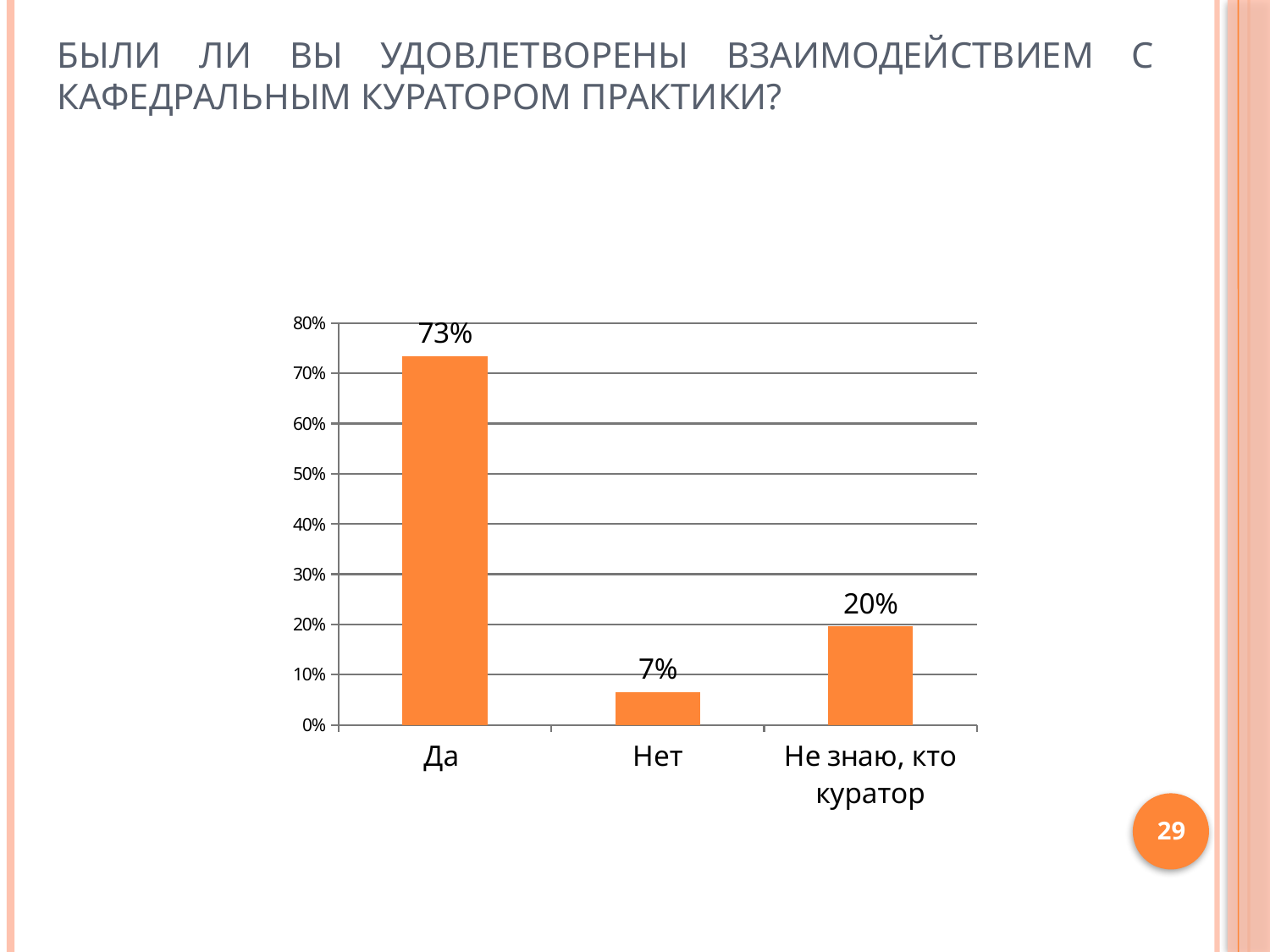
What kind of chart is shown on the slide? bar chart What is the difference between the values for "Не знаю, кто куратор" and "Нет"? 13% What is the value for "Нет"? 7% What is the value for "Да"? 73% Which is larger, the value for "Нет" or the value for "Не знаю, кто куратор"? Не знаю, кто куратор What is the value for "Не знаю, кто куратор"? 20% Is the value for "Да" greater or less than 70%? greater What is the maximum value shown on the vertical axis? 80% How many categories are shown on the x axis? 3 What is the difference between the values for "Да" and "Нет"? 66% Which category has the highest value? Да Which category has the lowest value? Нет